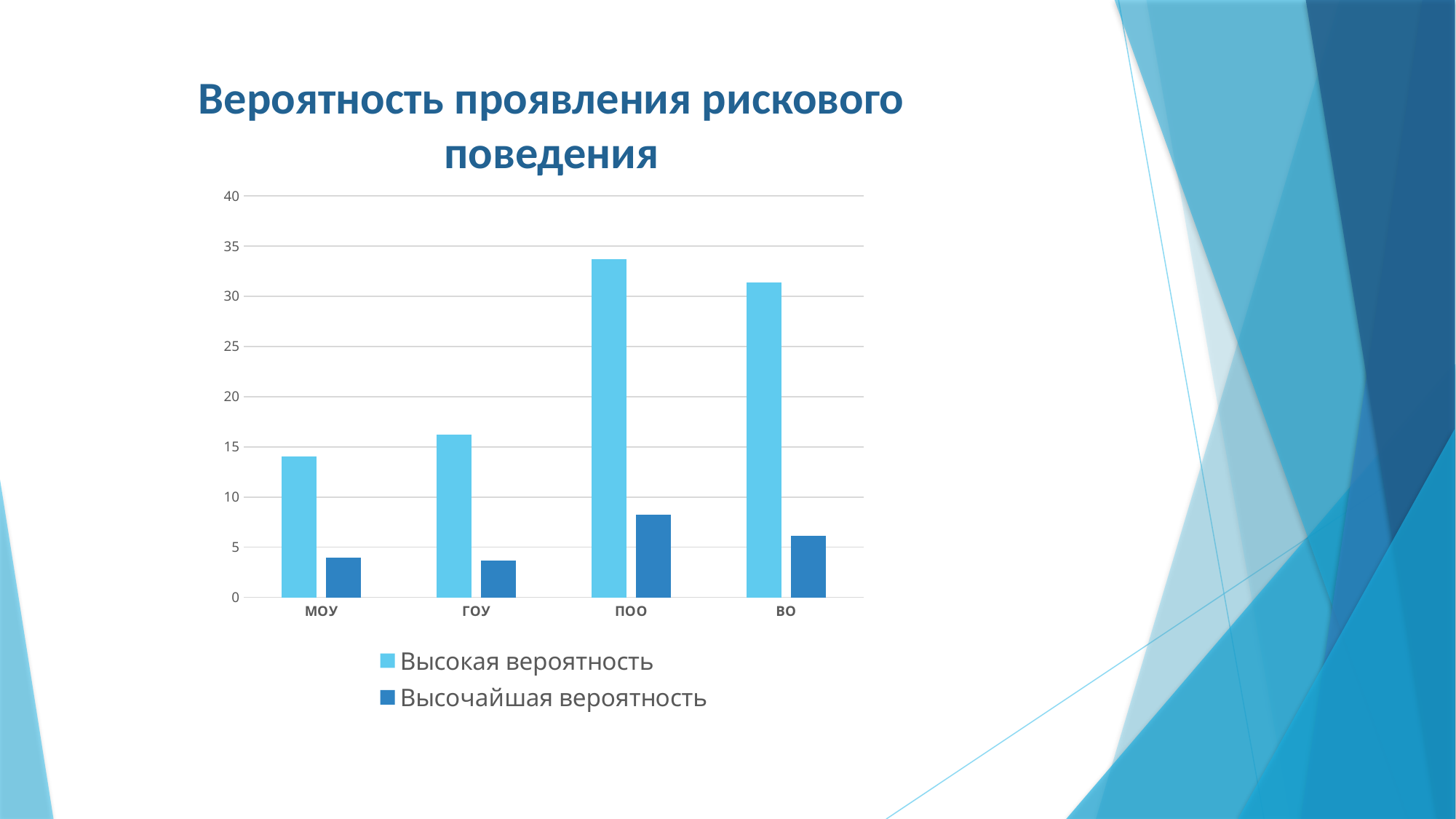
Which category has the lowest value for Высокая вероятность? МОУ Which series is shown in the darker blue colour in the legend? Высочайшая вероятность What is the title of the chart? Вероятность проявления рискового поведения Which category has the highest value for Высочайшая вероятность? ПОО Is the value for Высочайшая вероятность at ПОО greater or less than 10? less Which category has the highest value for Высокая вероятность? ПОО Is the value for Высокая вероятность at ПОО greater or less than 30? greater Which is larger: Высокая вероятность at МОУ or at ГОУ? ГОУ Is the value for Высокая вероятность at ГОУ greater or less than 15? greater How many series does the legend list? 2 What kind of chart is shown on the slide? bar chart How many categories are shown on the x axis? 4